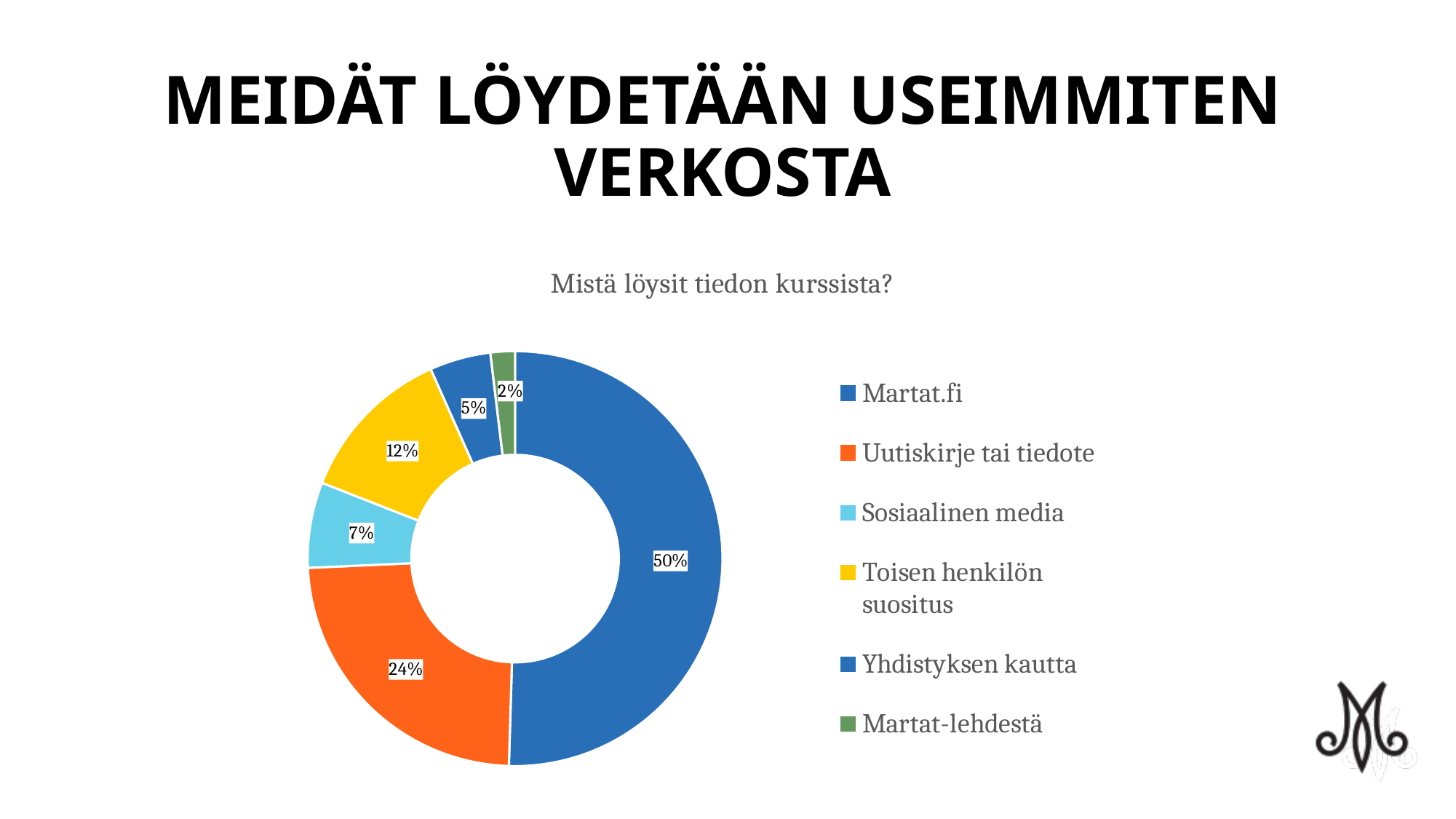
How many categories does the chart show? 6 What share of respondents found information about the course via Martat.fi? 50% What kind of chart is shown on the slide? Pie chart (doughnut) Which is larger, the share for Toisen henkilön suositus or the share for Sosiaalinen media? Toisen henkilön suositus What is the title of the chart? Mistä löysit tiedon kurssista? What percentage is shown for Toisen henkilön suositus? 12% What percentage is shown for Sosiaalinen media? 7% Which category has the largest share in the chart? Martat.fi Which category has the smallest share in the chart? Martat-lehdestä What is the difference in percentage points between Martat.fi and Uutiskirje tai tiedote? 26 What percentage is shown for Uutiskirje tai tiedote? 24% What percentage is shown for Martat-lehdestä? 2%